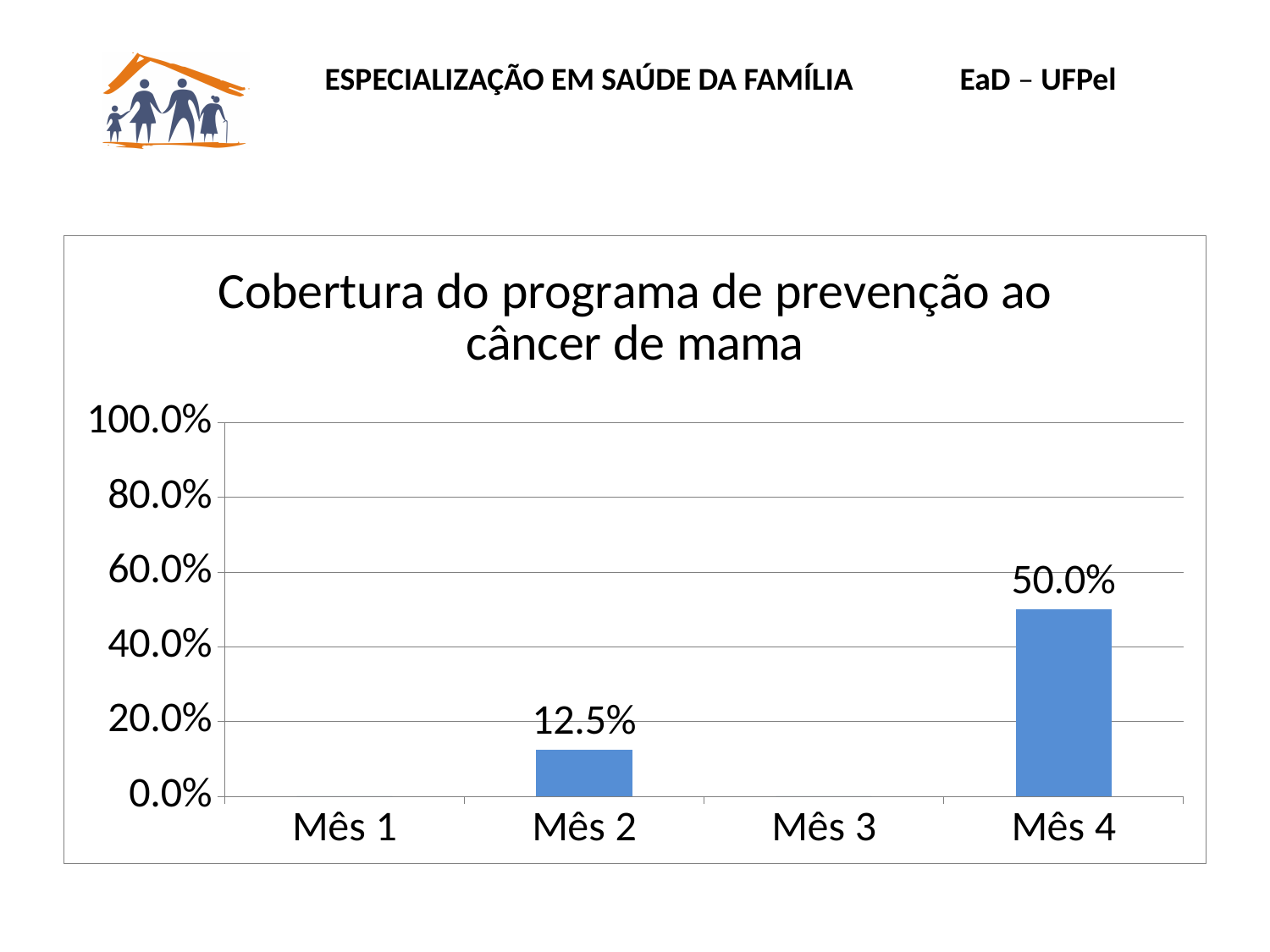
Is the value for Mês 2 greater or less than 20.0%? less What is the value for Mês 4? 50.0% Which month has the highest value? Mês 4 Which is larger, the value for Mês 2 or the value for Mês 4? Mês 4 What is the highest value shown on the y axis? 100.0% What is the difference between the values for Mês 4 and Mês 2? 37.5% What is the title of the chart? Cobertura do programa de prevenção ao câncer de mama Is the value for Mês 4 greater or less than 40.0%? greater How many months are shown on the x axis? 4 What is the value for Mês 2? 12.5% What kind of chart is shown on the slide? bar chart